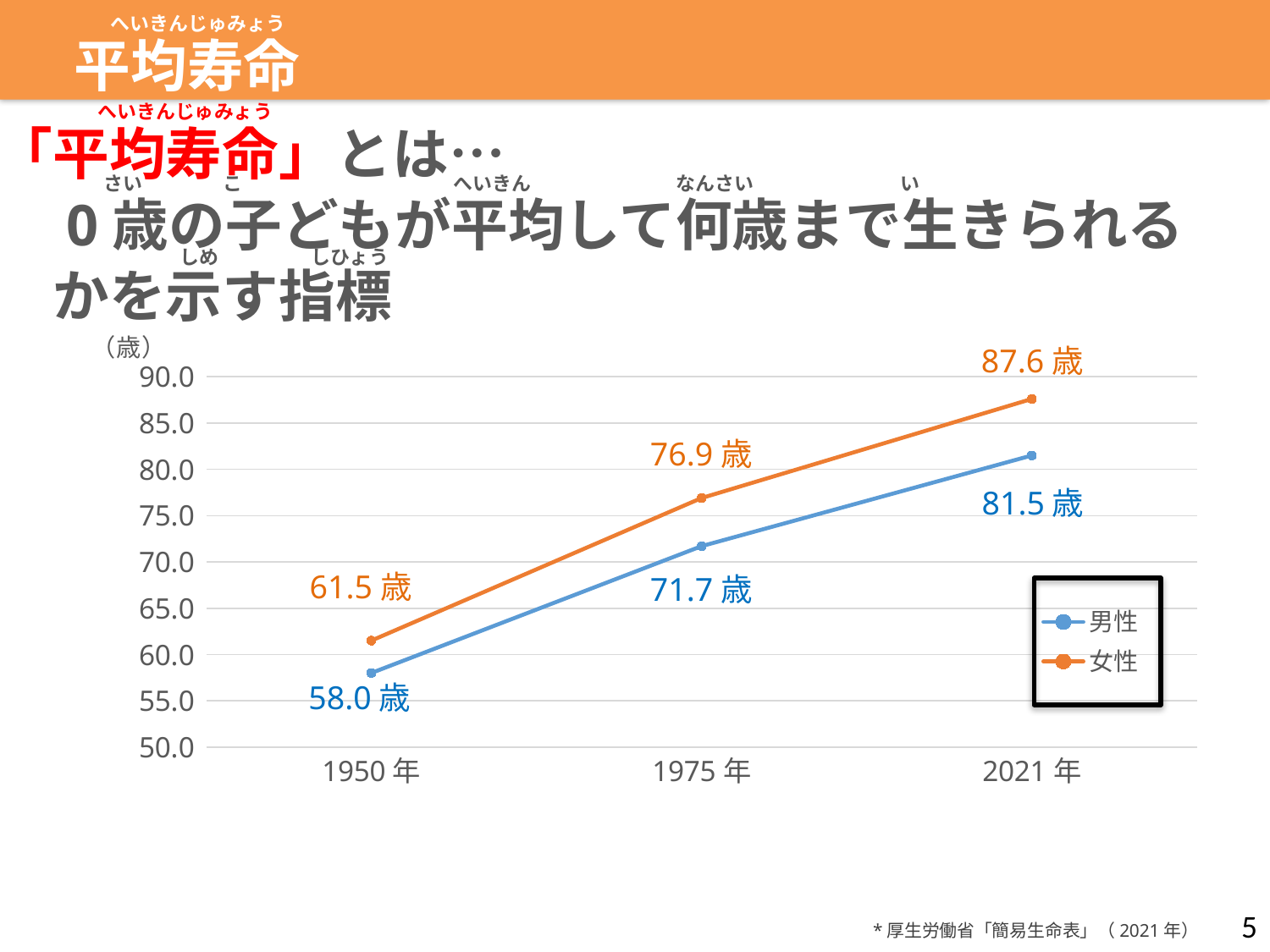
What is the value for 男性 (male) in 1950年? 58.0歳 What is the value for 女性 (female) in 1950年? 61.5歳 How many years are shown on the x axis? 3 Which is larger in 1975年, the value for 男性 (male) or 女性 (female)? 女性 Do the values for 男性 (male) rise or fall from 1950年 to 2021年? rise In which year is the value for 男性 (male) lowest? 1950年 What is the difference between the 女性 (female) and 男性 (male) values in 2021年? 6.1歳 How many series does the legend list? 2 What is the value for 男性 (male) in 1975年? 71.7歳 What kind of chart is shown on the slide? line chart What is the value for 女性 (female) in 2021年? 87.6歳 In which year is the value for 女性 (female) highest? 2021年